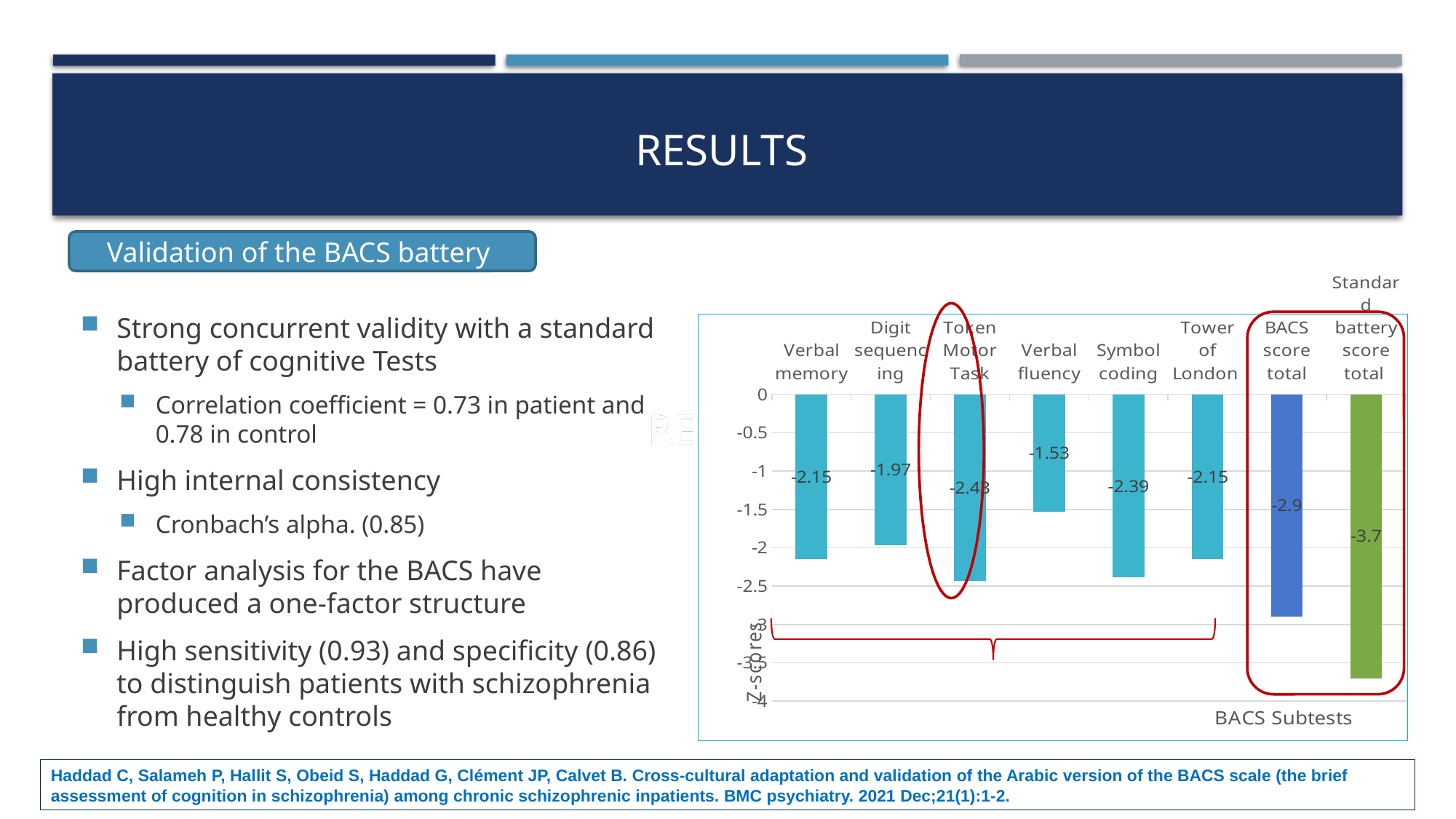
What is the value for Verbal fluency? -1.53 What kind of chart is shown? Bar chart What is the value for Verbal memory? -2.15 What is the difference between the values for BACS score total and Standard battery score total? 0.8 Which category has the highest (least negative) value? Verbal fluency How many categories are shown on the x axis? 8 Which is larger, the value for Digit sequencing or the value for Symbol coding? Digit sequencing Which category has the lowest (most negative) value? Standard battery score total What is the label of the vertical axis? Z-scores What is the value for Token Motor Task? -2.43 What is the value for BACS score total? -2.9 What is the value for Standard battery score total? -3.7